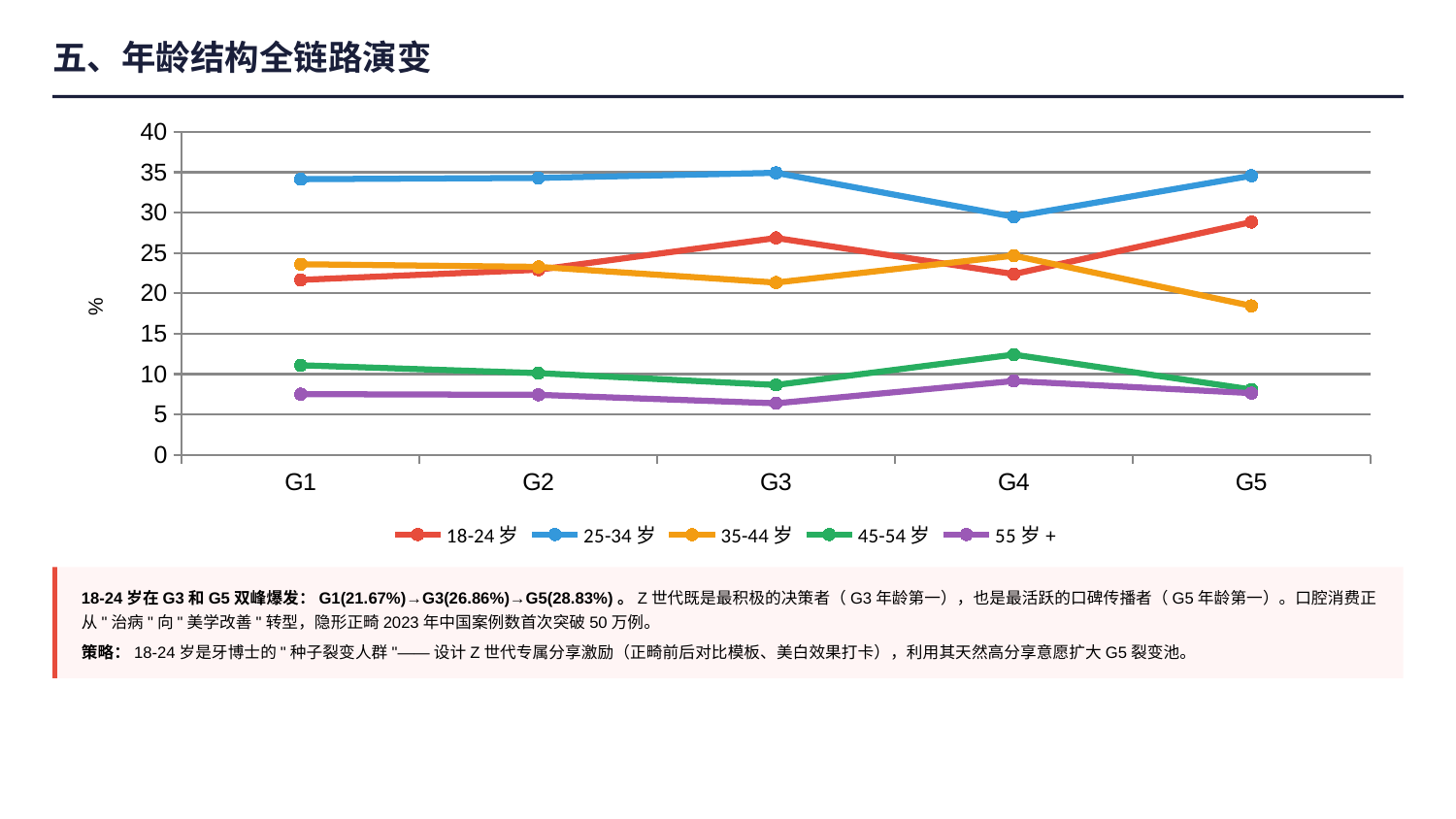
What colour is the line for 45-54 岁? green Which series has the lowest value at G3? 55 岁 + Which series has the highest value at G1? 25-34 岁 At G4, which is larger: the value for 35-44 岁 or the value for 18-24 岁? 35-44 岁 According to the slide, what is the value for 18-24 岁 at G5? 28.83% By how much does the 18-24 岁 value at G5 exceed its value at G1? 7.16% How many series does the legend list? 5 According to the slide, what is the value for 18-24 岁 at G3? 26.86% Is the value for 35-44 岁 at G5 greater or less than 20? less Does the 25-34 岁 line rise or fall from G3 to G4? fall What kind of chart is shown on the slide? line chart How many categories are shown on the x axis? 5